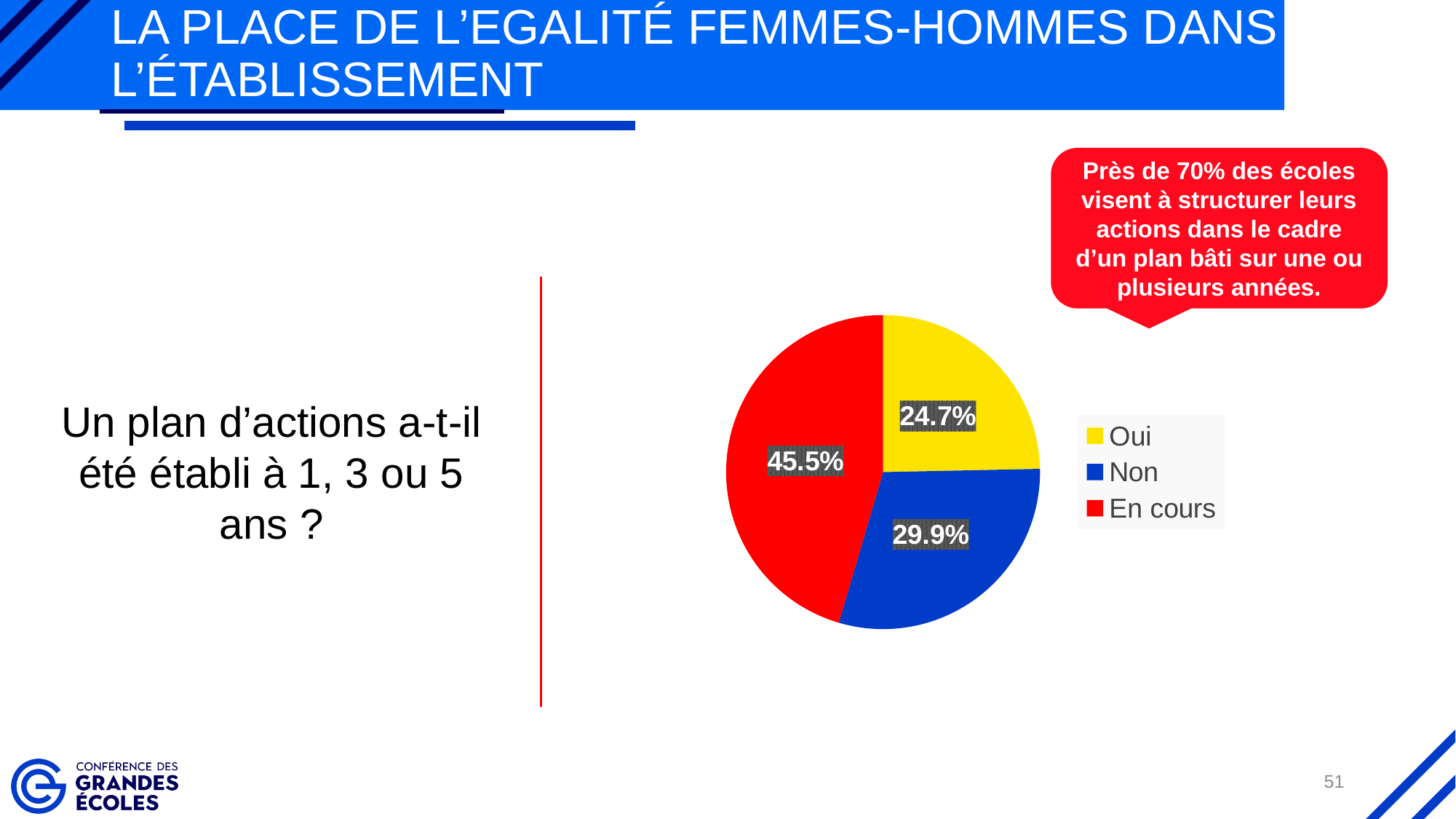
What kind of chart is shown on the slide? pie chart Which category has the smallest slice of the pie? Oui What is the difference in percentage points between the "Non" slice and the "Oui" slice? 5.2 What percentage of the pie is labelled "Oui"? 24.7% Which slice is larger, "Oui" or "Non"? Non What percentage of the pie is labelled "En cours"? 45.5% What is the difference in percentage points between the "En cours" slice and the "Non" slice? 15.6 Which category has the largest slice of the pie? En cours What colour is the "En cours" slice in the pie chart? red How many slices does the pie chart have? 3 What percentage of the pie is labelled "Non"? 29.9% Which category is shown in yellow in the legend? Oui